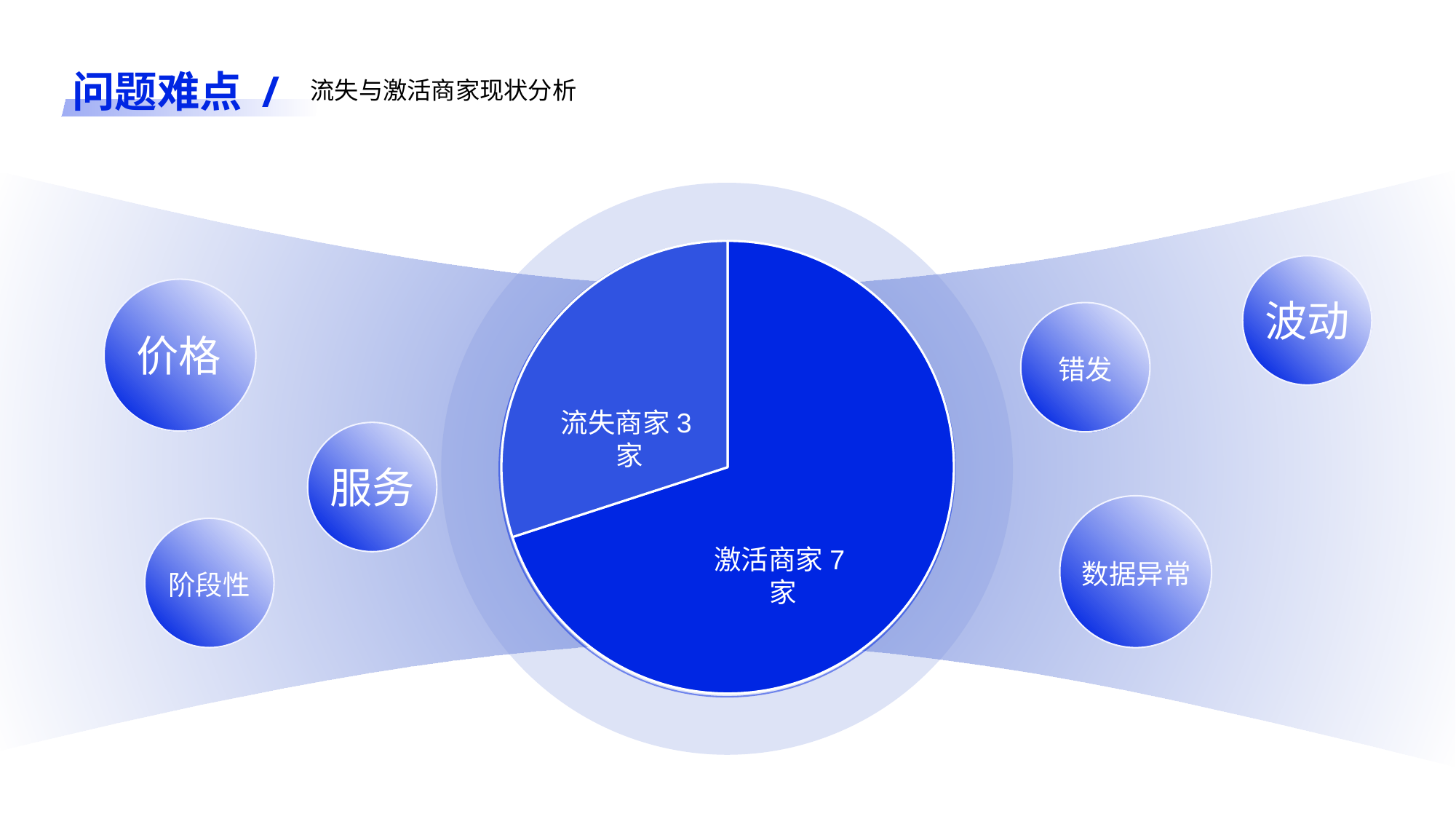
Which slice of the pie chart is the largest? 激活商家 What is the subtitle text next to 问题难点 at the top of the slide? 流失与激活商家现状分析 What is the total number of merchants represented in the pie chart? 10 家 Which is larger in the pie chart, 流失商家 or 激活商家? 激活商家 What share of the pie chart does 流失商家 represent? 30% What is the difference between the number of 激活商家 and 流失商家 in the pie chart? 4 家 How many slices does the pie chart have? 2 What is the value shown for 激活商家 in the pie chart? 7 家 What share of the pie chart does 激活商家 represent? 70% Which slice of the pie chart is the smallest? 流失商家 What kind of chart is shown on the slide? Pie chart What is the value shown for 流失商家 in the pie chart? 3 家